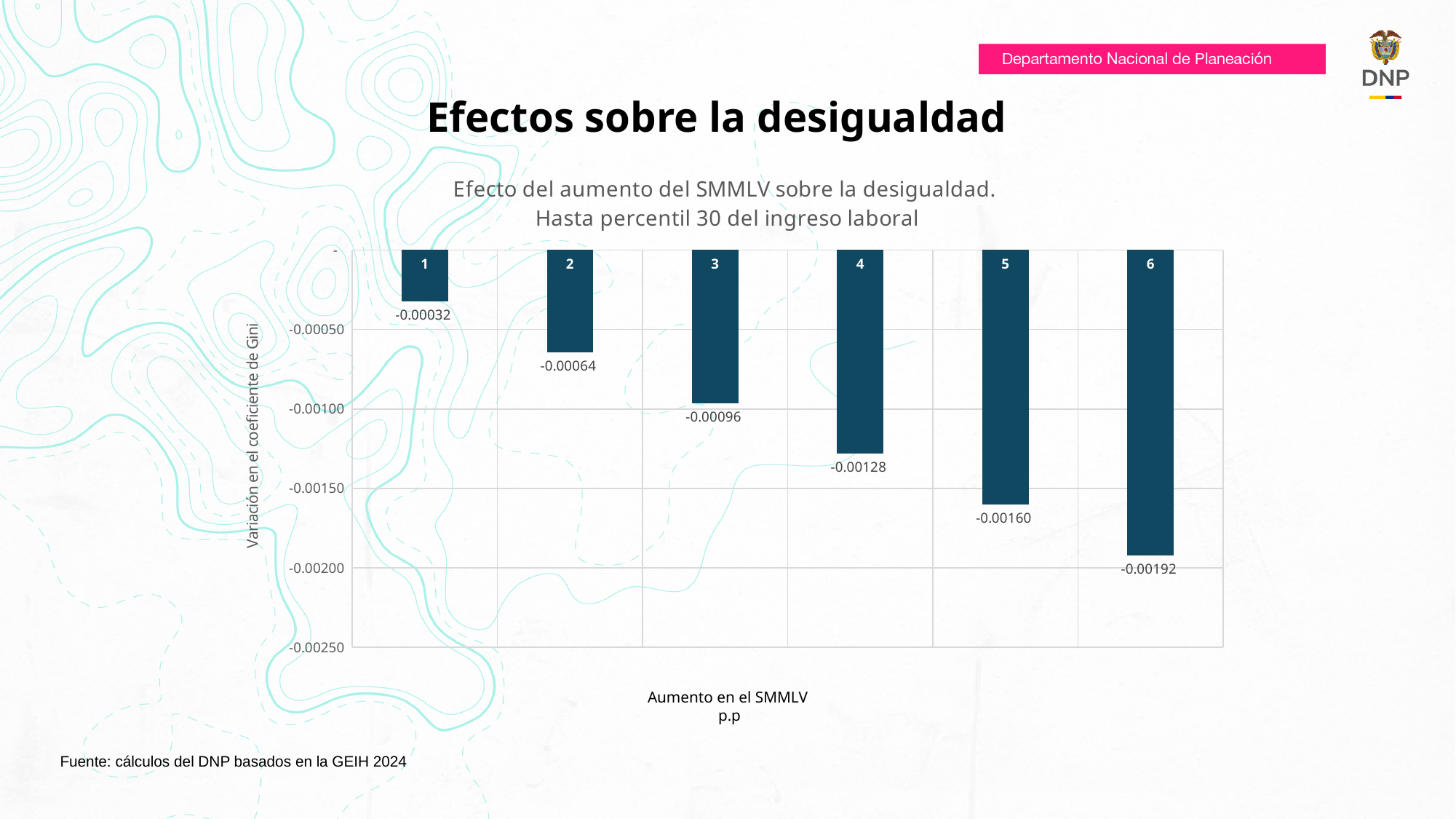
Which is larger, the value for an SMMLV increase of 2 p.p. or 4 p.p.? 2 p.p. Which SMMLV increase has the highest (least negative) variation in the Gini coefficient? 1 What is the value for an SMMLV increase of 1 p.p.? -0.00032 Is the value for an SMMLV increase of 4 p.p. greater or less than -0.00100? less How many categories (SMMLV increase levels) are shown on the chart? 6 Which SMMLV increase has the lowest (most negative) variation in the Gini coefficient? 6 What kind of chart is shown on the slide? Bar chart What is the difference between the values for an SMMLV increase of 5 p.p. and 2 p.p.? 0.00096 What is the value for an SMMLV increase of 3 p.p.? -0.00096 What is the value for an SMMLV increase of 6 p.p.? -0.00192 Do the values rise or fall as the SMMLV increase goes from 1 to 6 p.p.? Fall What is the label of the vertical axis of the chart? Variación en el coeficiente de Gini